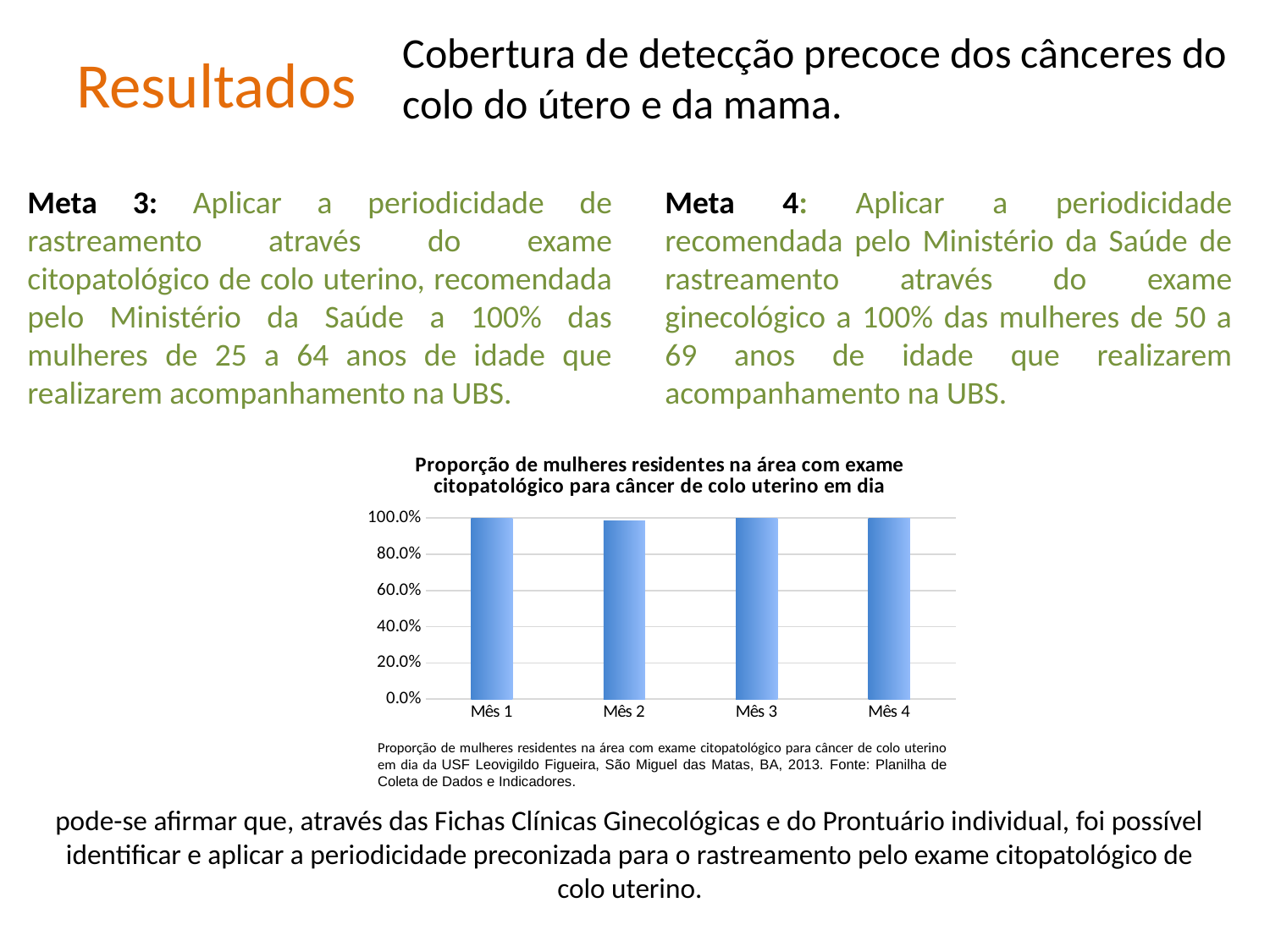
Is the value for Mês 3 greater or less than 80.0%? greater Is the value for Mês 2 greater or less than 60.0%? greater Is the value for Mês 4 greater or less than 40.0%? greater What is the highest value shown on the y axis? 100.0% What kind of chart is shown on the slide? bar chart What is the label of the first category on the x axis? Mês 1 Which is larger, the value for Mês 1 or the value for Mês 2? Mês 1 What is the title of the chart? Proporção de mulheres residentes na área com exame citopatológico para câncer de colo uterino em dia Which month has the lowest value on the chart? Mês 2 How many categories (months) are plotted on the chart? 4